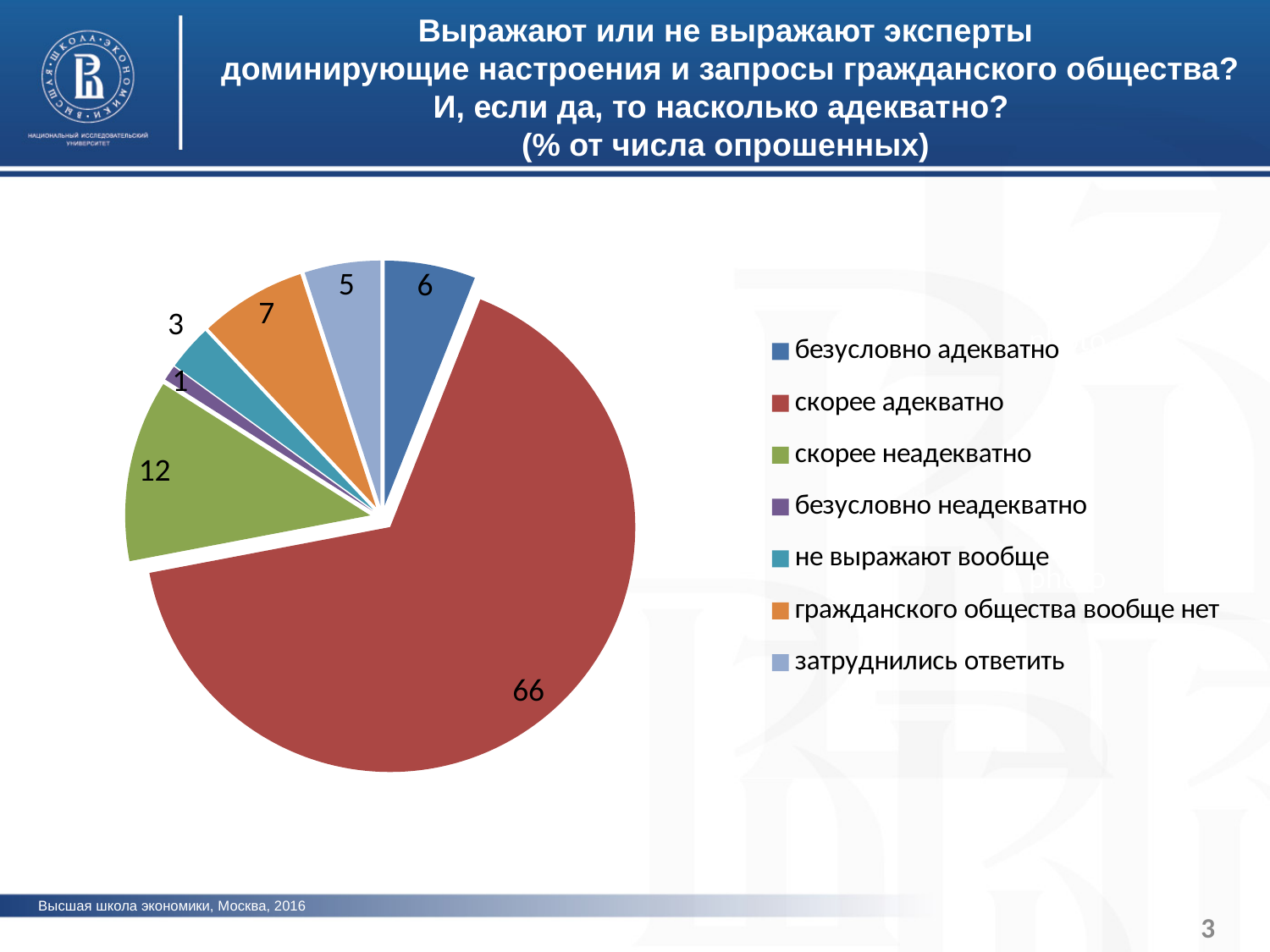
What is the value for "затруднились ответить"? 5 What is the value for "скорее неадекватно"? 12 What is the value for "безусловно адекватно"? 6 What is the value for "скорее адекватно"? 66 Which is larger: the value for "гражданского общества вообще нет" or the value for "не выражают вообще"? гражданского общества вообще нет How many categories does the pie chart have? 7 Which category has the largest slice of the pie? скорее адекватно What is the value for "гражданского общества вообще нет"? 7 Which category has the smallest slice of the pie? безусловно неадекватно What type of chart is shown on the slide? pie chart What is the difference between the values for "скорее адекватно" and "скорее неадекватно"? 54 What colour is the slice for "скорее адекватно"? red